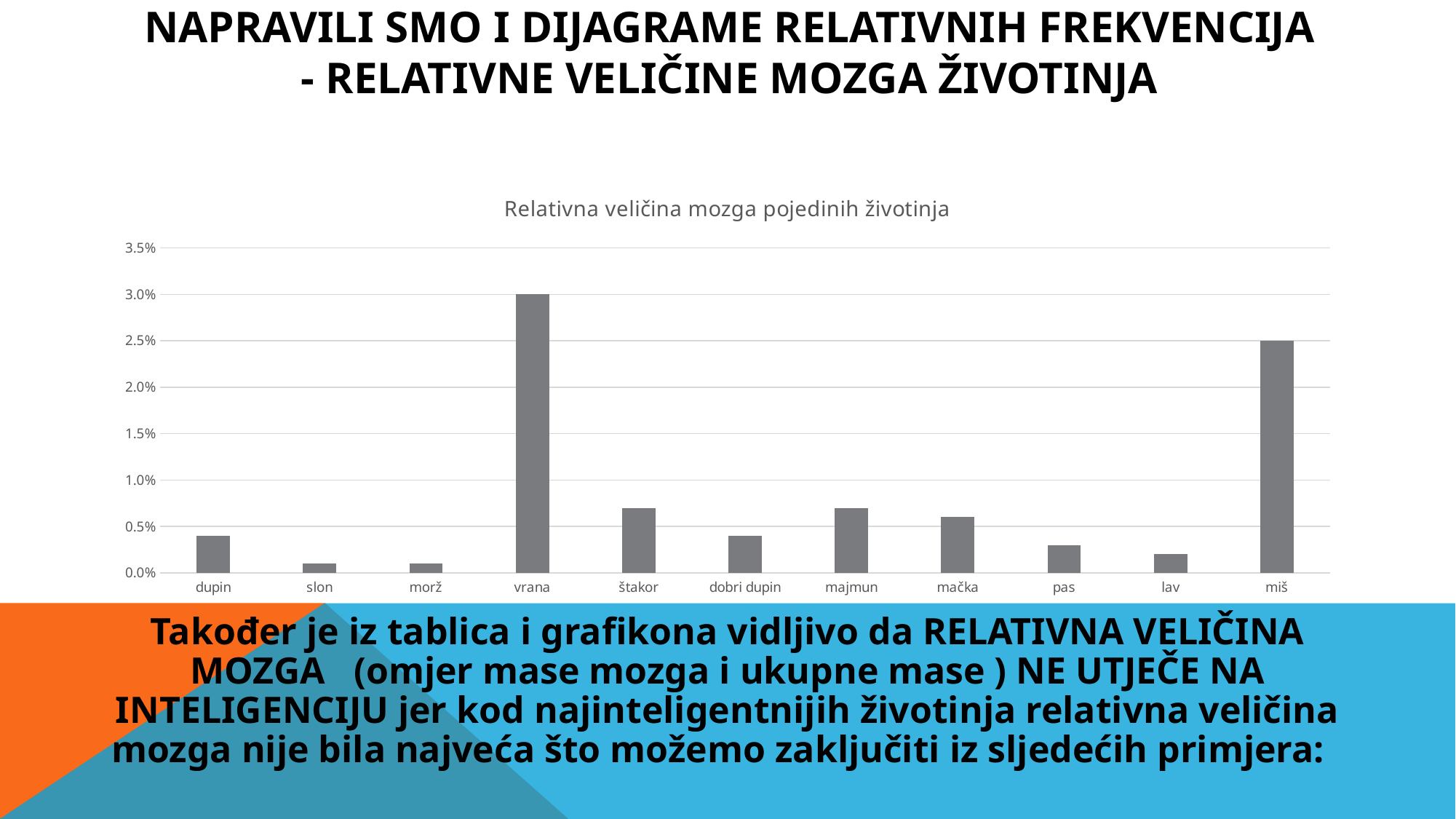
Which animal has the highest relative brain size in the chart? vrana Is the value for pas greater or less than 0.5%? less How many animal categories are shown on the x axis of the chart? 11 What is the value for miš in the chart? 2.5% Is the value for štakor greater or less than 0.5%? greater Which has a larger value, štakor or pas? štakor Which has a larger value, vrana or miš? vrana What kind of chart is shown on the slide? bar chart Is the value for miš greater or less than 2.0%? greater What is the difference between the values for vrana and miš? 0.5% What is the title of the chart? Relativna veličina mozga pojedinih životinja What is the value for vrana in the chart? 3.0%